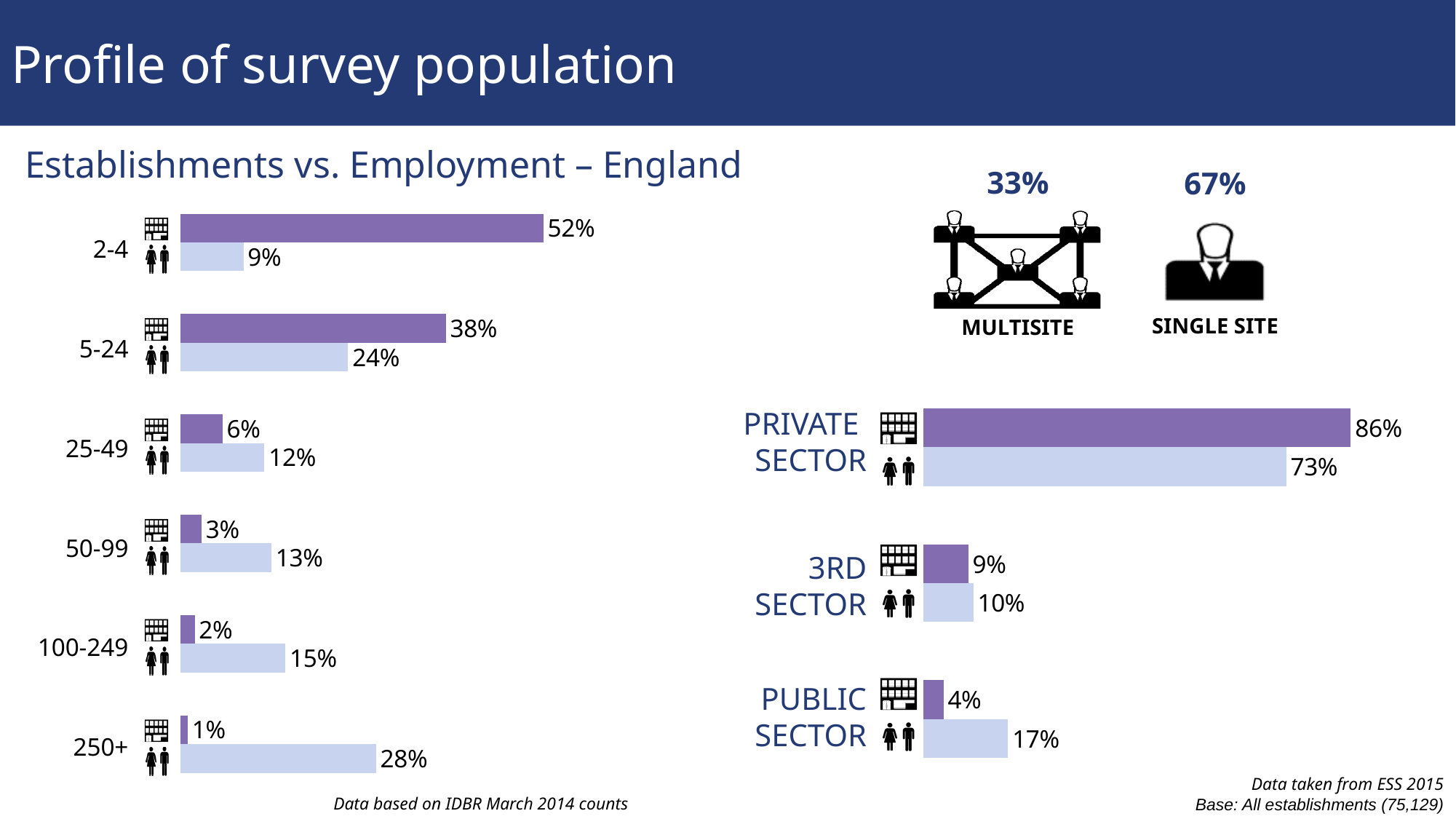
In the right chart by sector, which is larger: the light blue (employment) value for the 3rd Sector or for the Public Sector? Public Sector In the left chart (Establishments vs. Employment – England), what is the difference between the dark purple and light blue values for the 5-24 size band? 14% In the left chart (Establishments vs. Employment – England), which size band has the lowest light blue (employment) value? 2-4 In the left chart (Establishments vs. Employment – England), how many size bands are shown? 6 In the right chart by sector, what is the dark purple (establishments) value for the Private Sector? 86% In the right chart by sector, what is the difference between the dark purple and light blue values for the Private Sector? 13% In the left chart (Establishments vs. Employment – England), do the dark purple (establishments) values rise or fall as the size band increases from 2-4 to 250+? fall In the left chart (Establishments vs. Employment – England), what is the dark purple (establishments) value for the 2-4 size band? 52% In the left chart (Establishments vs. Employment – England), which size band has the highest dark purple (establishments) value? 2-4 In the left chart (Establishments vs. Employment – England), what is the light blue (employment) value for the 250+ size band? 28% What kind of chart is used for the Establishments vs. Employment – England data on the left? bar chart In the right chart by sector, what is the light blue (employment) value for the Public Sector? 17%